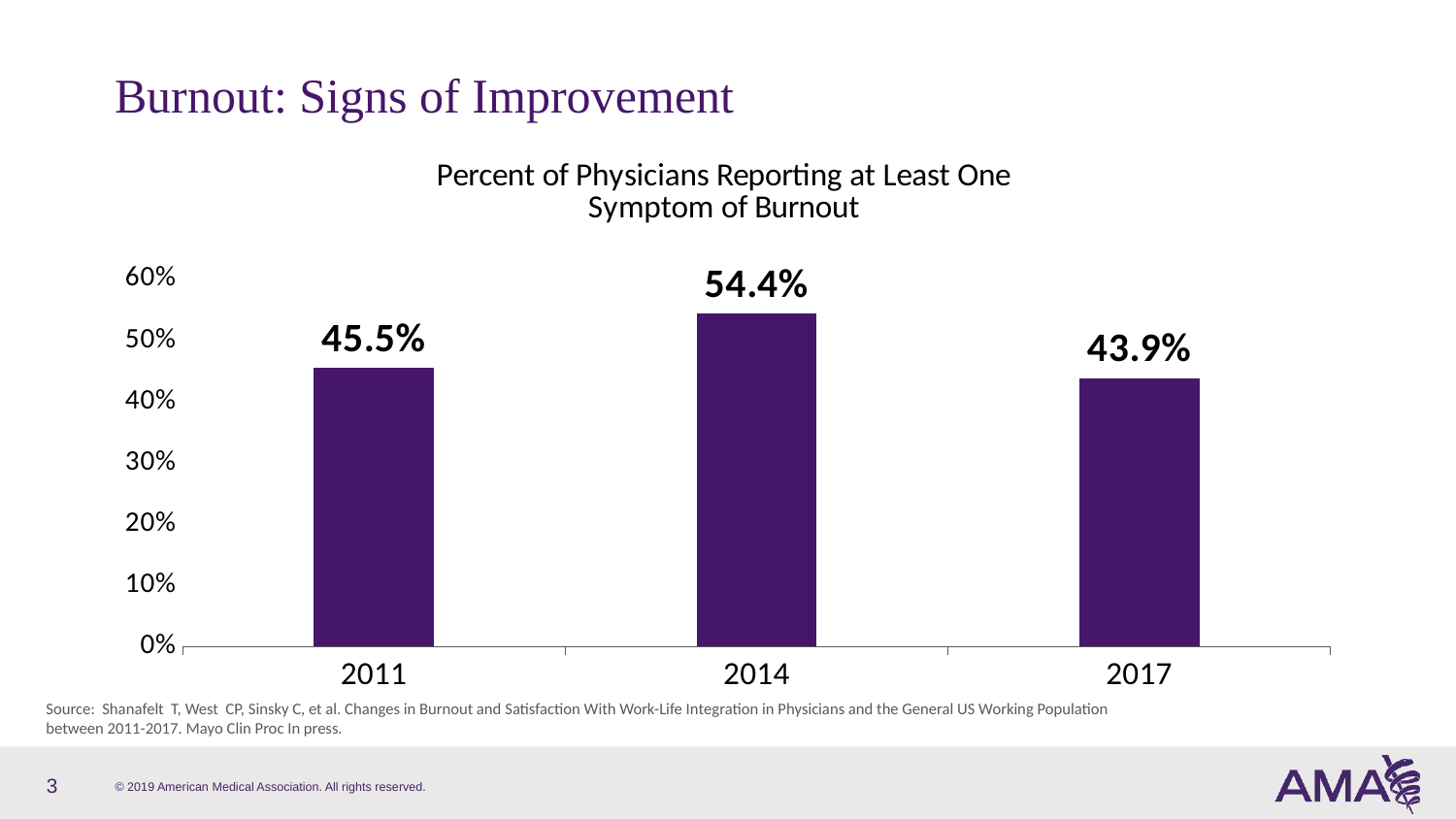
What is the difference in percentage points between the 2011 and 2017 values? 1.6 Which year has the lowest percent of physicians reporting at least one symptom of burnout? 2017 Is the value for 2014 greater or less than 50%? greater What is the difference in percentage points between the 2014 and 2017 values? 10.5 How many years are shown on the chart? 3 What is the title of the chart? Percent of Physicians Reporting at Least One Symptom of Burnout What percent of physicians reported at least one symptom of burnout in 2017? 43.9% What percent of physicians reported at least one symptom of burnout in 2011? 45.5% What percent of physicians reported at least one symptom of burnout in 2014? 54.4% Which year has the highest percent of physicians reporting at least one symptom of burnout? 2014 What kind of chart is shown on the slide? Bar chart Which year has a larger value, 2011 or 2014? 2014